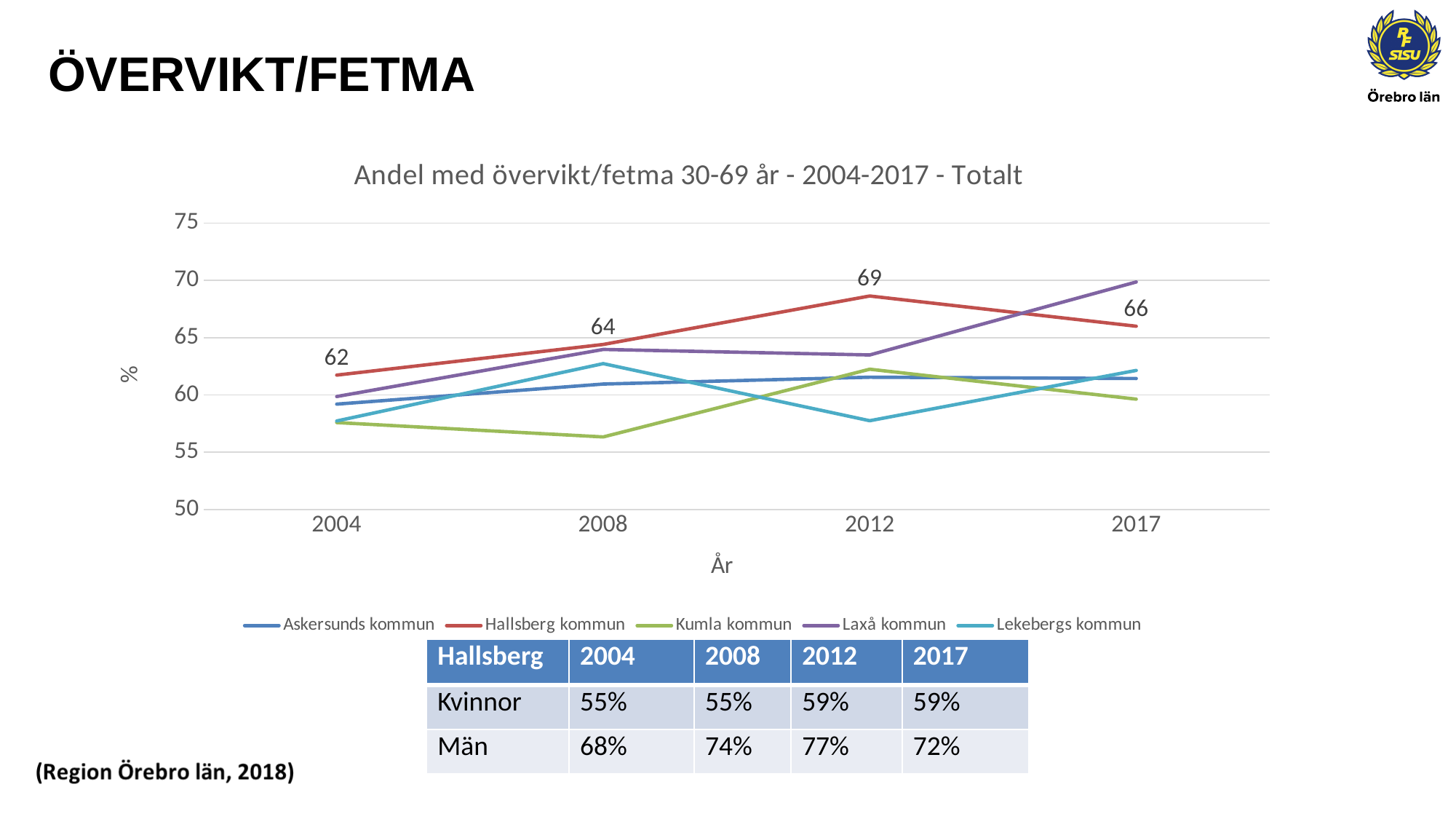
In which year does Hallsberg kommun reach its highest value? 2012 What is the difference between the Hallsberg kommun values for 2012 and 2017? 3 By how much did the Hallsberg kommun value increase from 2004 to 2012? 7 Is the value for Laxå kommun in 2017 greater or less than 65? greater How many series does the legend list? 5 What is the value for Hallsberg kommun in 2012? 69 What is the title of the chart? Andel med övervikt/fetma 30-69 år - 2004-2017 - Totalt What is the value for Hallsberg kommun in 2004? 62 What kind of chart is shown on the slide? line chart How many years are shown on the x axis? 4 In 2017, which is higher: Laxå kommun or Hallsberg kommun? Laxå kommun Is the value for Kumla kommun in 2008 greater or less than 60? less